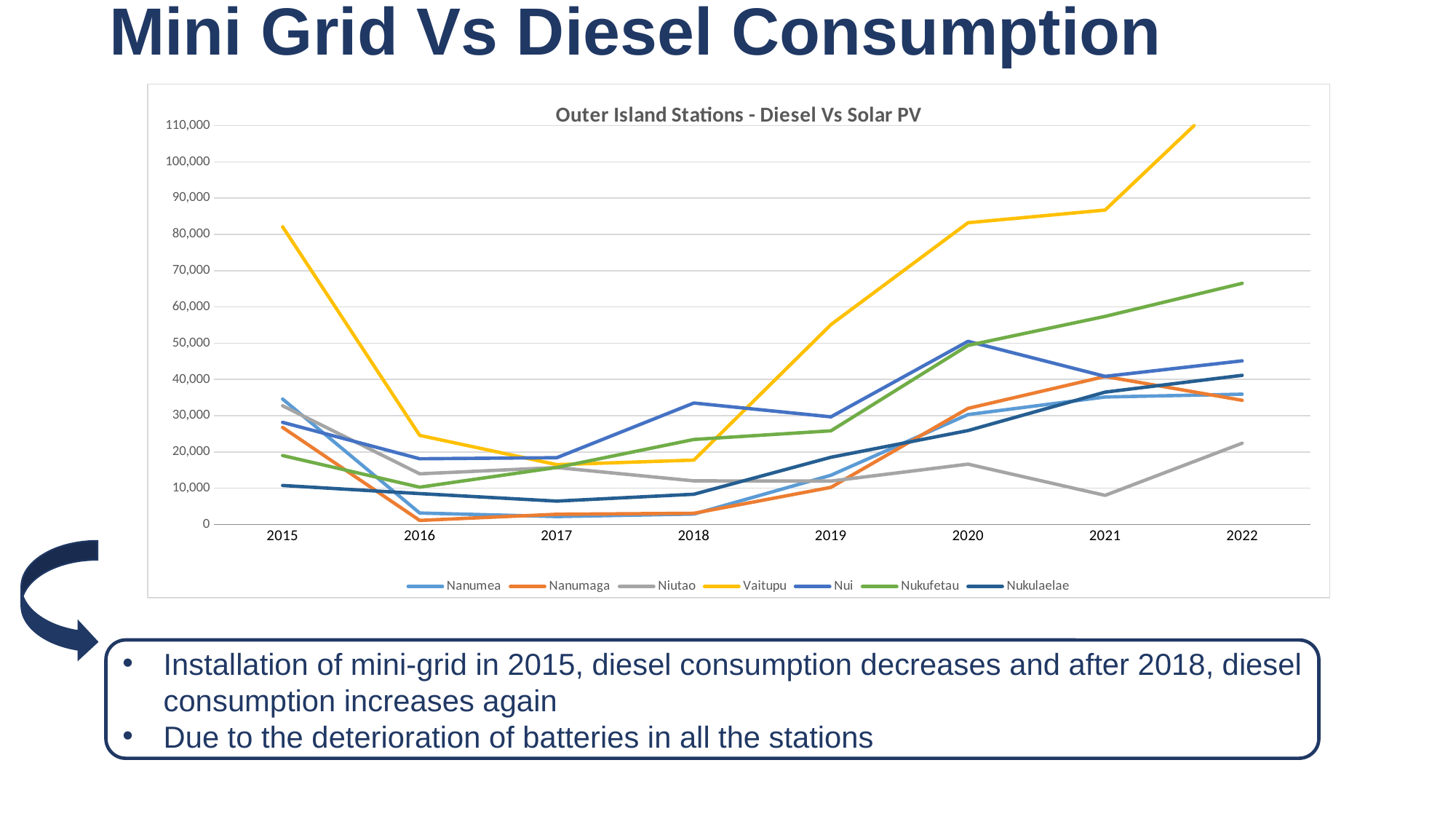
What kind of chart is shown on the slide? line chart Which station has the highest value in 2022? Vaitupu Is the value for Niutao in 2021 greater or less than 10,000? less How many years are shown on the x axis? 8 What is the title of the chart? Outer Island Stations - Diesel Vs Solar PV In 2022, which is larger: Nukufetau or Nui? Nukufetau Which station has the highest value in 2015? Vaitupu Does the Vaitupu line rise or fall from 2018 to 2022? rises How many series does the legend list? 7 Is the value for Nukufetau in 2022 greater or less than 60,000? greater Is the value for Vaitupu in 2015 greater or less than 70,000? greater Which station has the lowest value in 2021? Niutao